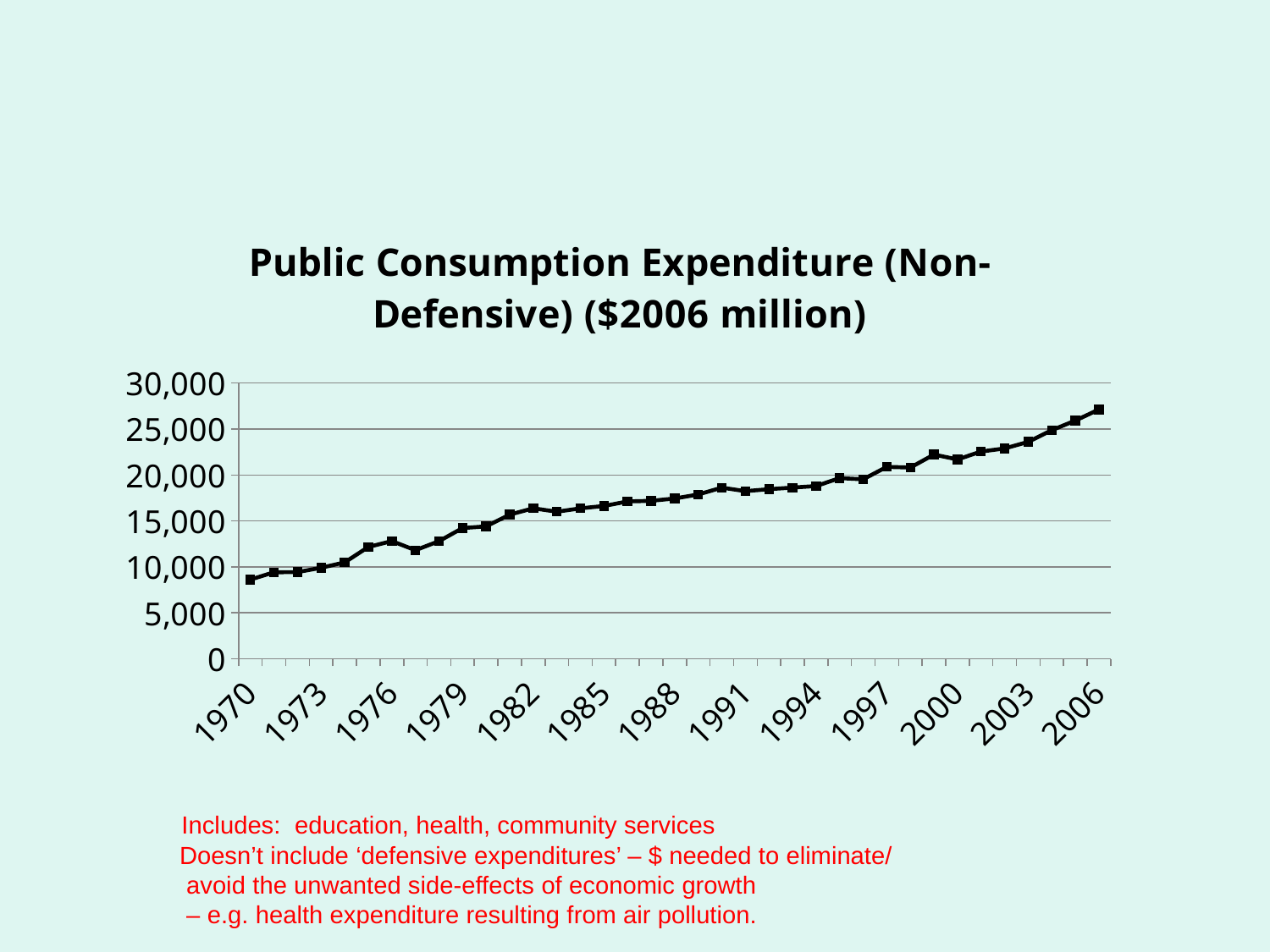
Is the value for 1991 greater or less than 20,000? less Which year has the lowest value on the chart? 1970 Is the value for 2006 greater or less than 25,000? greater Is the value for 1970 greater or less than 10,000? less Which year has the larger value, 1976 or 1994? 1994 What kind of chart is shown on the slide? line chart Which year has the highest value on the chart? 2006 What is the title of the chart? Public Consumption Expenditure (Non-Defensive) ($2006 million) Do the values generally rise or fall from 1970 to 2006? rise What is the first year shown on the x axis? 1970